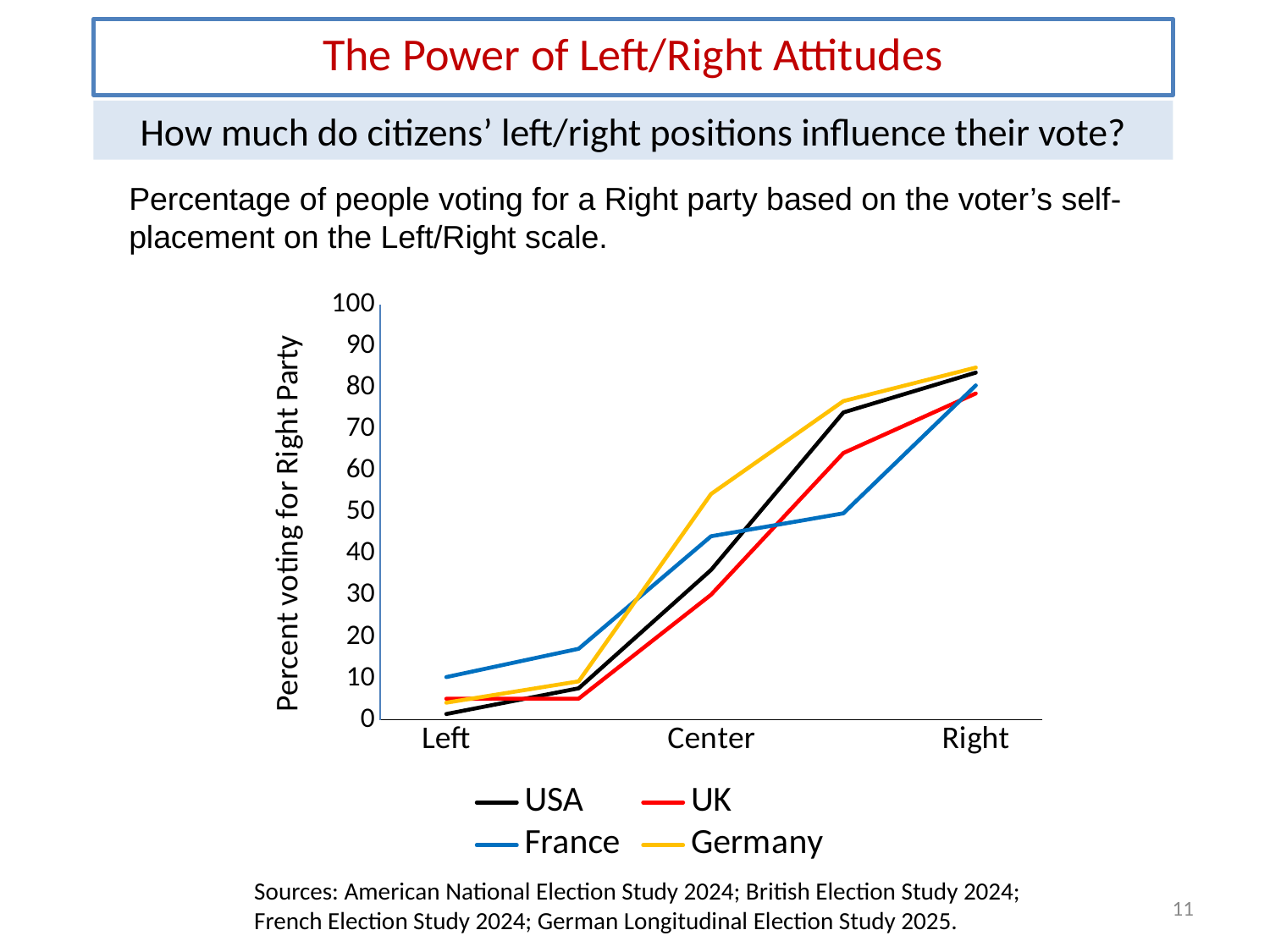
Is the value for France at Center greater or less than 30? greater How many series does the legend list? 4 At Left, which series has the highest value? France Is the value for Germany at Center greater or less than 40? greater At Right, which is larger: the value for Germany or the value for UK? Germany How many labeled categories are shown on the x axis? 3 Is the value for UK at Right greater or less than 70? greater What kind of chart is shown on the slide? line chart At Center, which series has the highest value? Germany What is the title of the y axis? Percent voting for Right Party Do the values for the USA line rise or fall moving from Left to Right along the x axis? rise